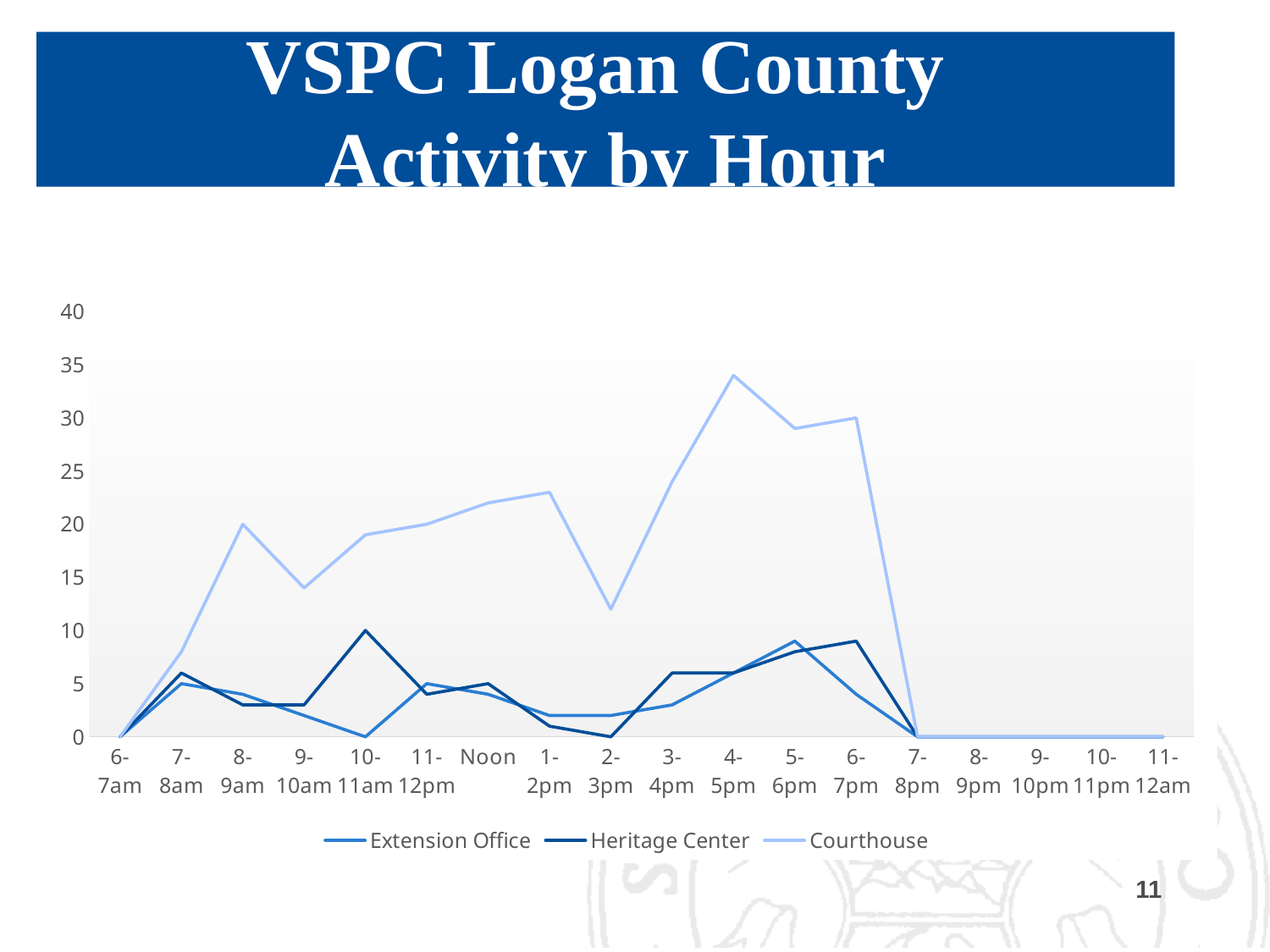
How many series does the legend list? 3 What is the value for Courthouse at 8-9pm? 0 At which hour does the Courthouse series reach its highest value? 4-5pm Which series are listed in the legend? Extension Office, Heritage Center, Courthouse Is the value for Courthouse at 2-3pm greater or less than 15? less What kind of chart is shown on the slide? Line chart Is the value for Courthouse at 4-5pm greater or less than 30? greater Does the Courthouse series rise or fall from 6-7pm to 7-8pm? Fall What is the value for Heritage Center at 10-11am? 10 How many hourly categories are shown on the x axis? 18 What is the value for Courthouse at 6-7pm? 30 At 4-5pm, which series has the larger value, Courthouse or Heritage Center? Courthouse